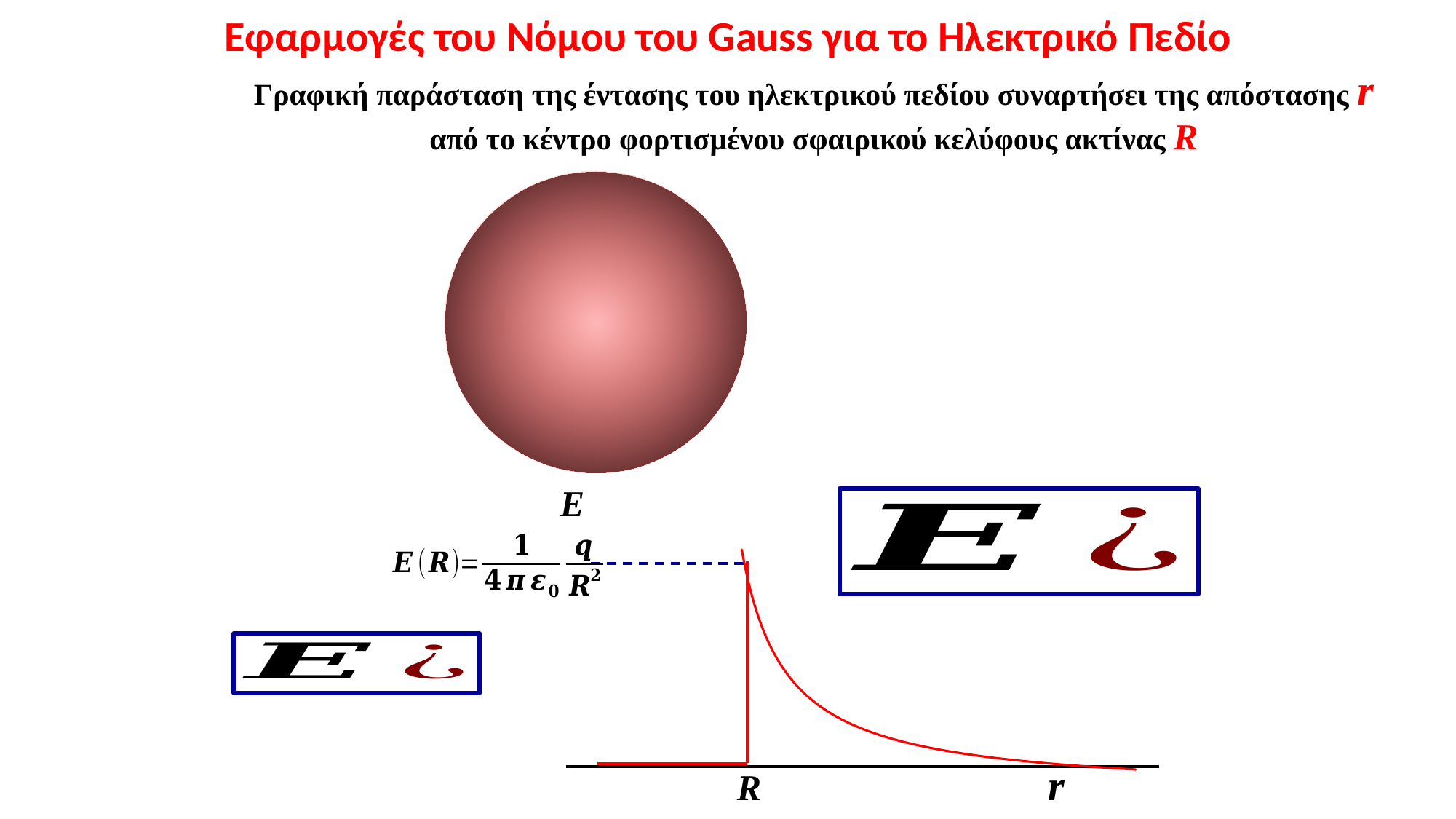
What expression does the slide give for the electric field at r = R? E(R) = 1/(4πε₀) · q/R² How many curves (series) are plotted on the graph? 1 For distances r greater than R, does the electric field E rise or fall as r increases? fall What colour is the plotted E(r) curve? red What is the value of E for distances r less than R (inside the shell)? 0 What quantity is plotted on the horizontal axis of the graph? r Is the electric field larger just outside the shell (r slightly greater than R) or far from the shell (large r)? just outside the shell At which value of r does the electric field E reach its maximum? R What kind of chart is shown at the bottom of the slide? line chart What quantity is plotted on the vertical axis of the graph? E